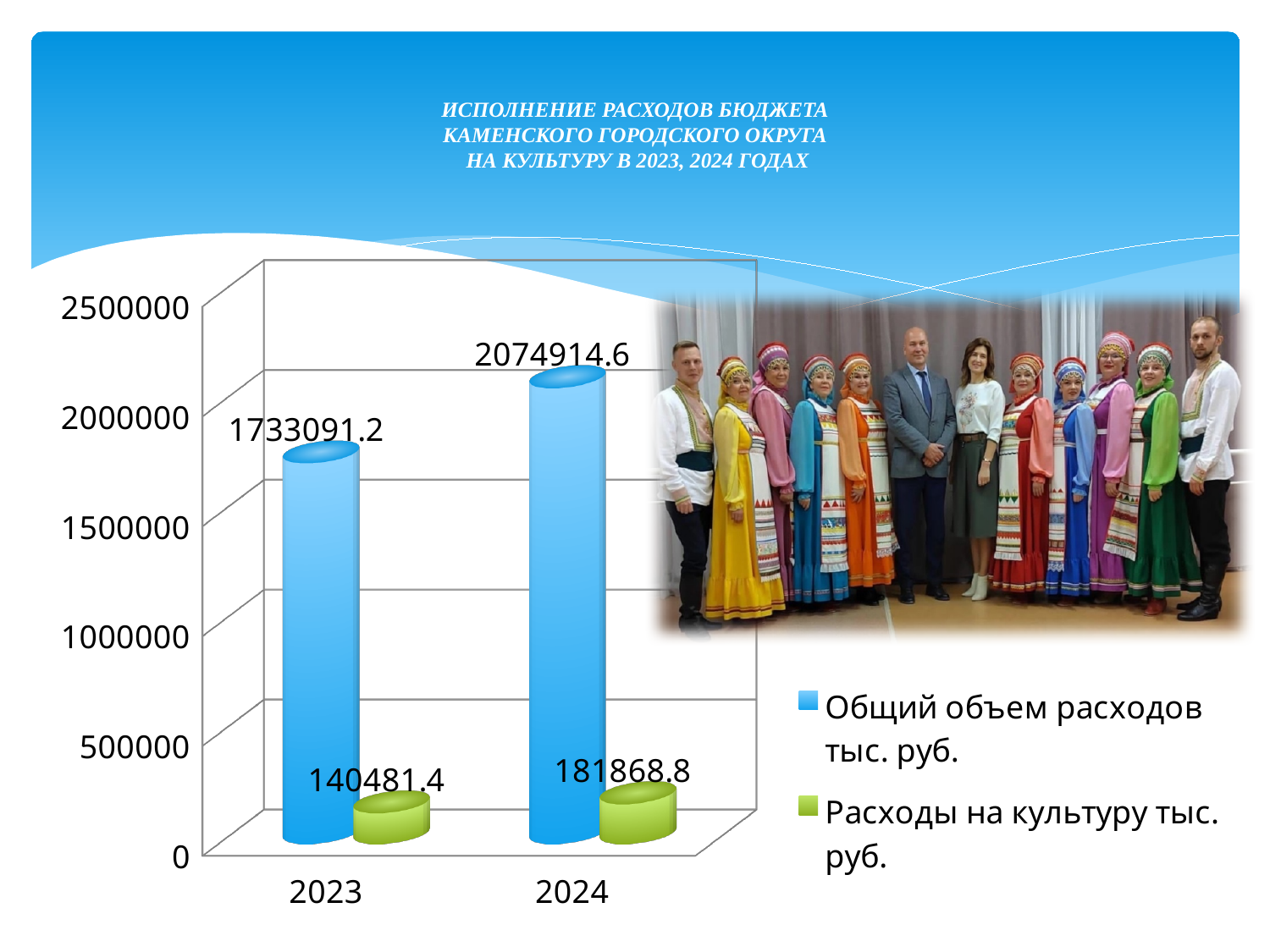
By how much did "Общий объем расходов тыс. руб." increase from 2023 to 2024? 341823.4 Which year has the higher value for "Расходы на культуру тыс. руб."? 2024 What is the difference between "Расходы на культуру тыс. руб." in 2024 and in 2023? 41387.4 What is the value of "Общий объем расходов тыс. руб." for 2023? 1733091.2 How many years (categories) are shown on the x axis of the chart? 2 Does "Общий объем расходов тыс. руб." rise or fall from 2023 to 2024? Rise What is the value of "Общий объем расходов тыс. руб." for 2024? 2074914.6 How many series does the chart legend list? 2 What kind of chart is shown on the slide? Bar chart Is the value of "Общий объем расходов тыс. руб." for 2024 greater or less than 2000000? greater What is the value of "Расходы на культуру тыс. руб." for 2024? 181868.8 What is the value of "Расходы на культуру тыс. руб." for 2023? 140481.4